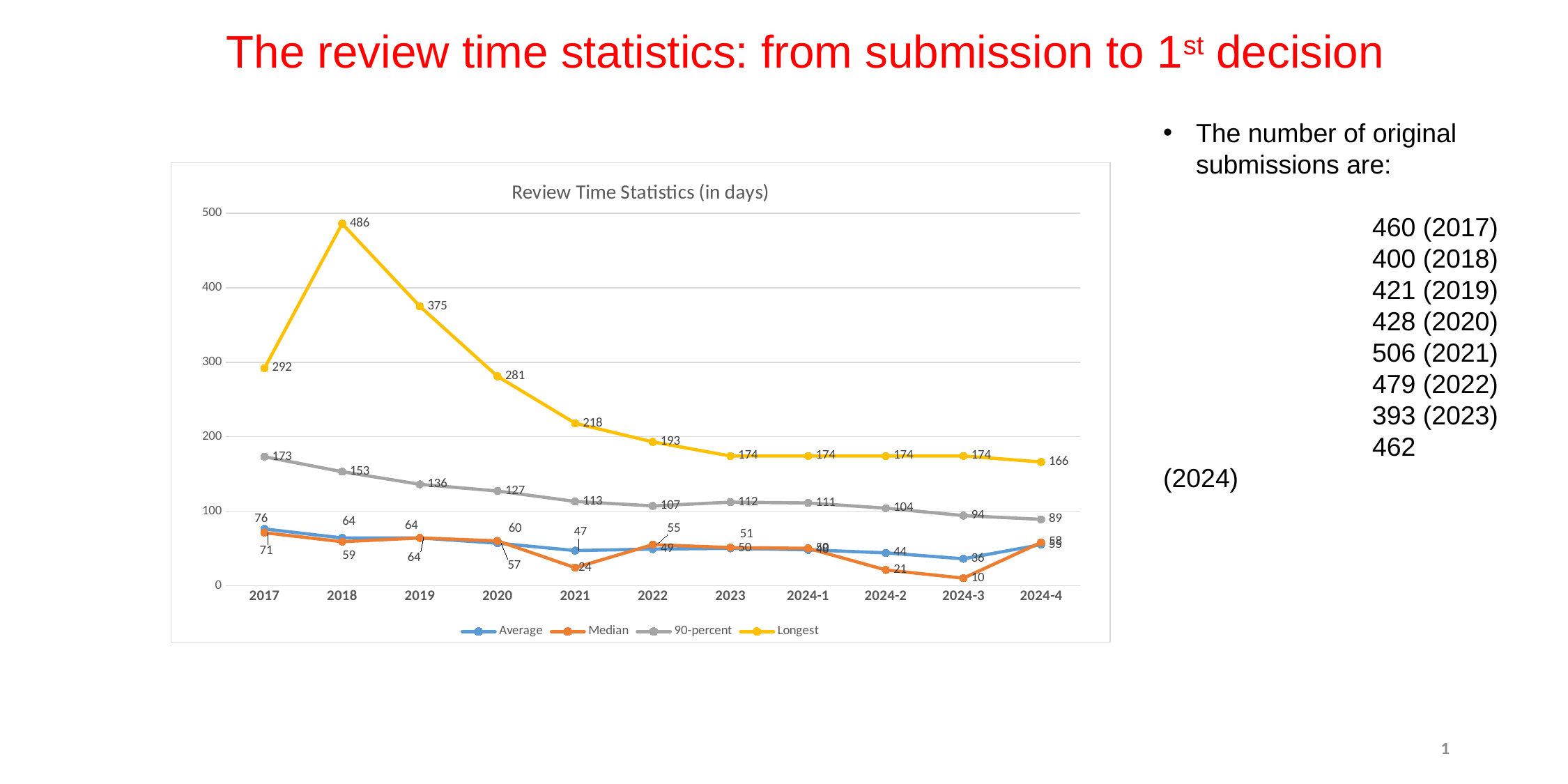
What is the value of the Longest series in 2018? 486 What is the Median value in 2021? 24 How many series does the legend of the chart list? 4 What is the title of the chart? Review Time Statistics (in days) How many categories are shown along the x axis of the chart? 11 What is the difference between the Longest values for 2018 and 2017? 194 What is the value of the 90-percent series in 2024-4? 89 What kind of chart is shown on the slide? line chart In which category does the Median series have its lowest value? 2024-3 Which is larger: the 90-percent value in 2017 or the Longest value in 2024-4? 90-percent value in 2017 Does the 90-percent series generally rise or fall from 2017 to 2024-4? fall In which category does the Longest series reach its highest value? 2018